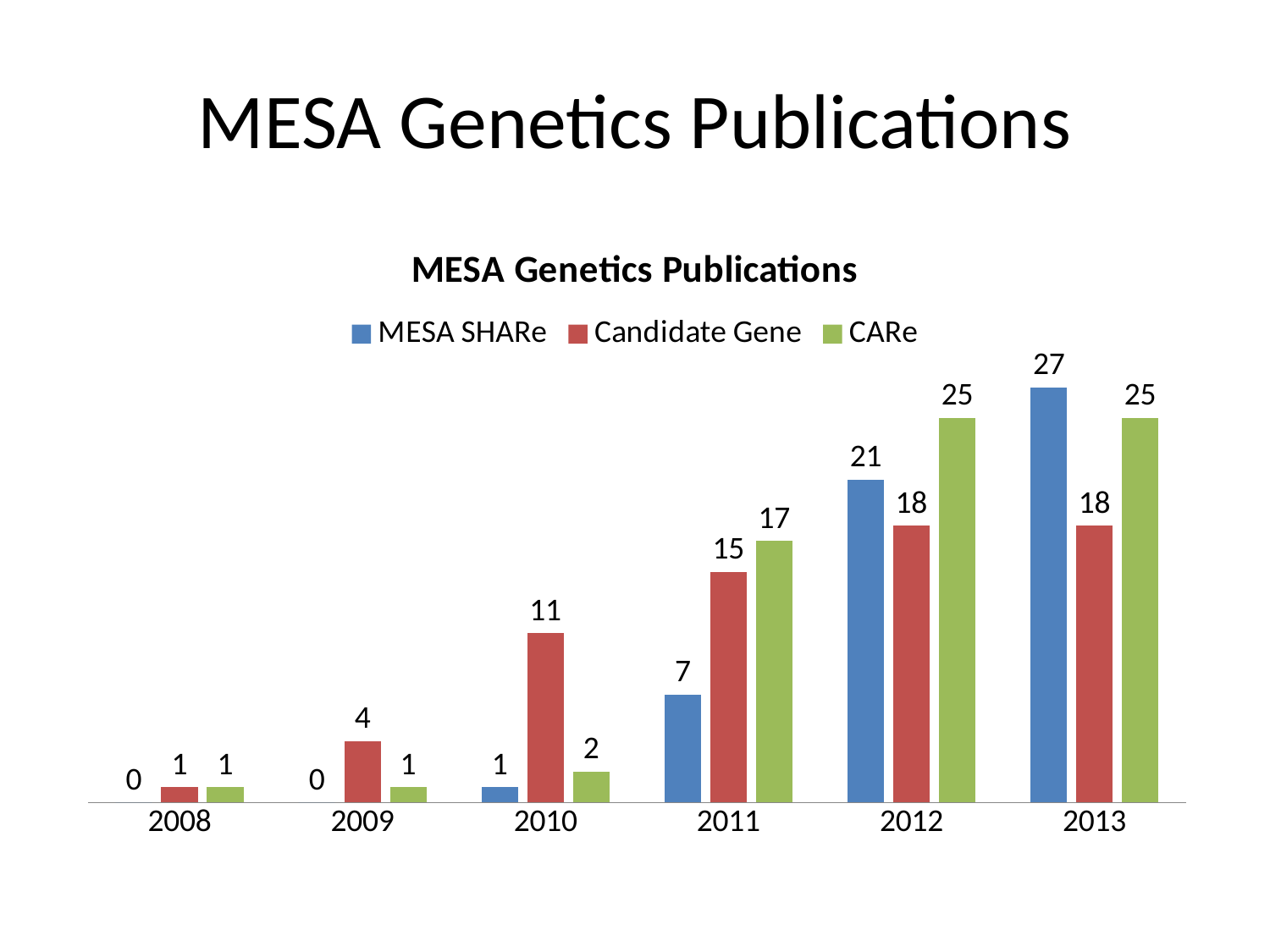
Which is larger in 2011, MESA SHARe or Candidate Gene? Candidate Gene Which year has the highest value for MESA SHARe? 2013 Do the MESA SHARe values rise or fall from 2008 to 2013? rise What kind of chart is shown? bar chart How many years are shown on the x axis? 6 What is the value for MESA SHARe in 2013? 27 What is the title of the chart? MESA Genetics Publications How many series does the legend list? 3 Which year has the lowest value for Candidate Gene? 2008 What is the value for CARe in 2011? 17 What is the difference between the CARe value in 2012 and the Candidate Gene value in 2012? 7 What is the value for Candidate Gene in 2010? 11